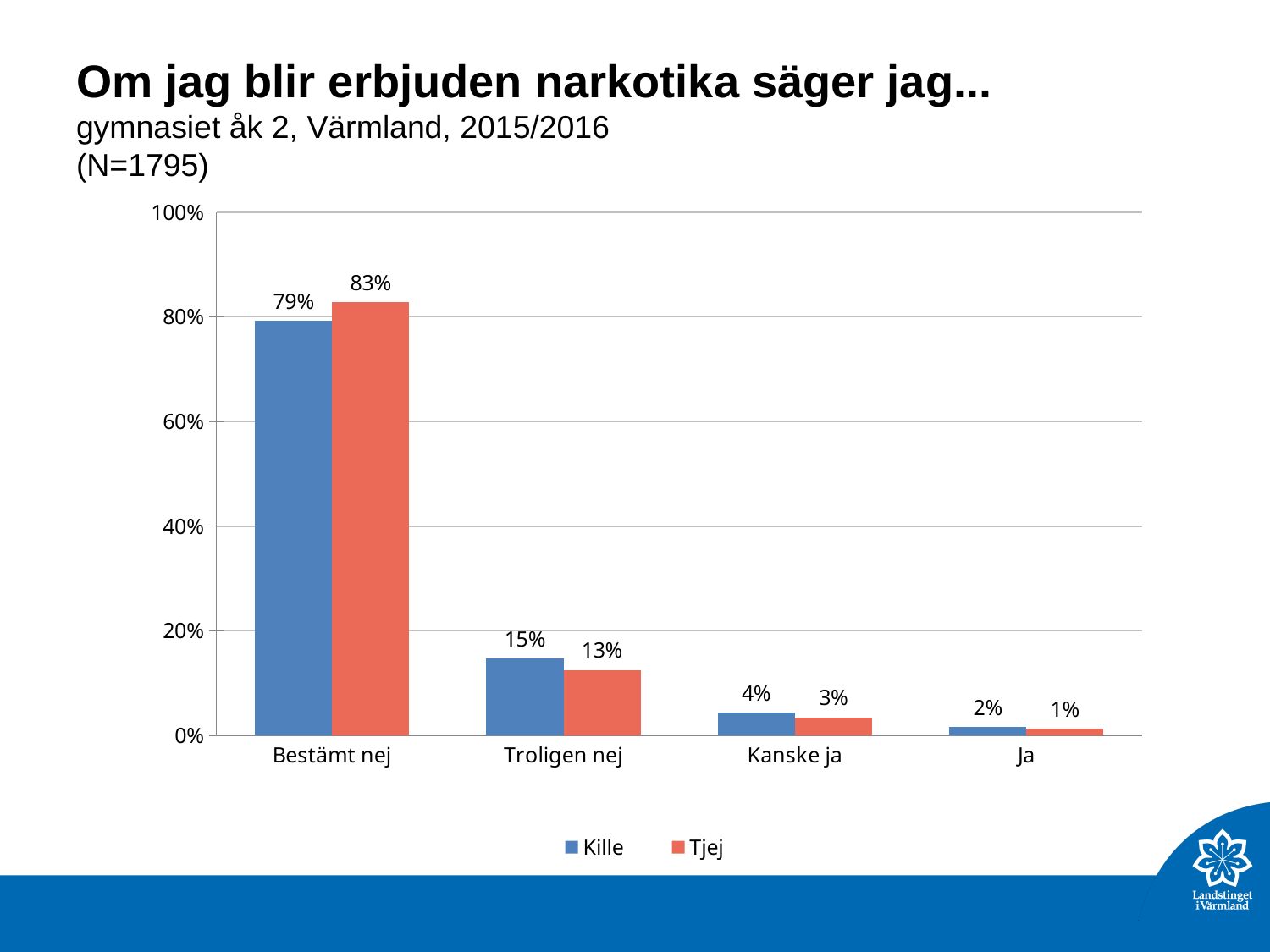
Which category has the highest value for Tjej? Bestämt nej What is the difference between Tjej and Kille in the Bestämt nej category? 4% How many categories are shown on the x axis? 4 What is the value for Tjej in the Troligen nej category? 13% What is the value for Tjej in the Ja category? 1% Which is larger in the Kanske ja category, Kille or Tjej? Kille What is the value for Kille in the Bestämt nej category? 79% How many series does the legend list? 2 What is the difference between Kille and Tjej in the Troligen nej category? 2% What kind of chart is shown on the slide? Bar chart Which category has the lowest value for Kille? Ja Which series is shown in orange in the legend? Tjej